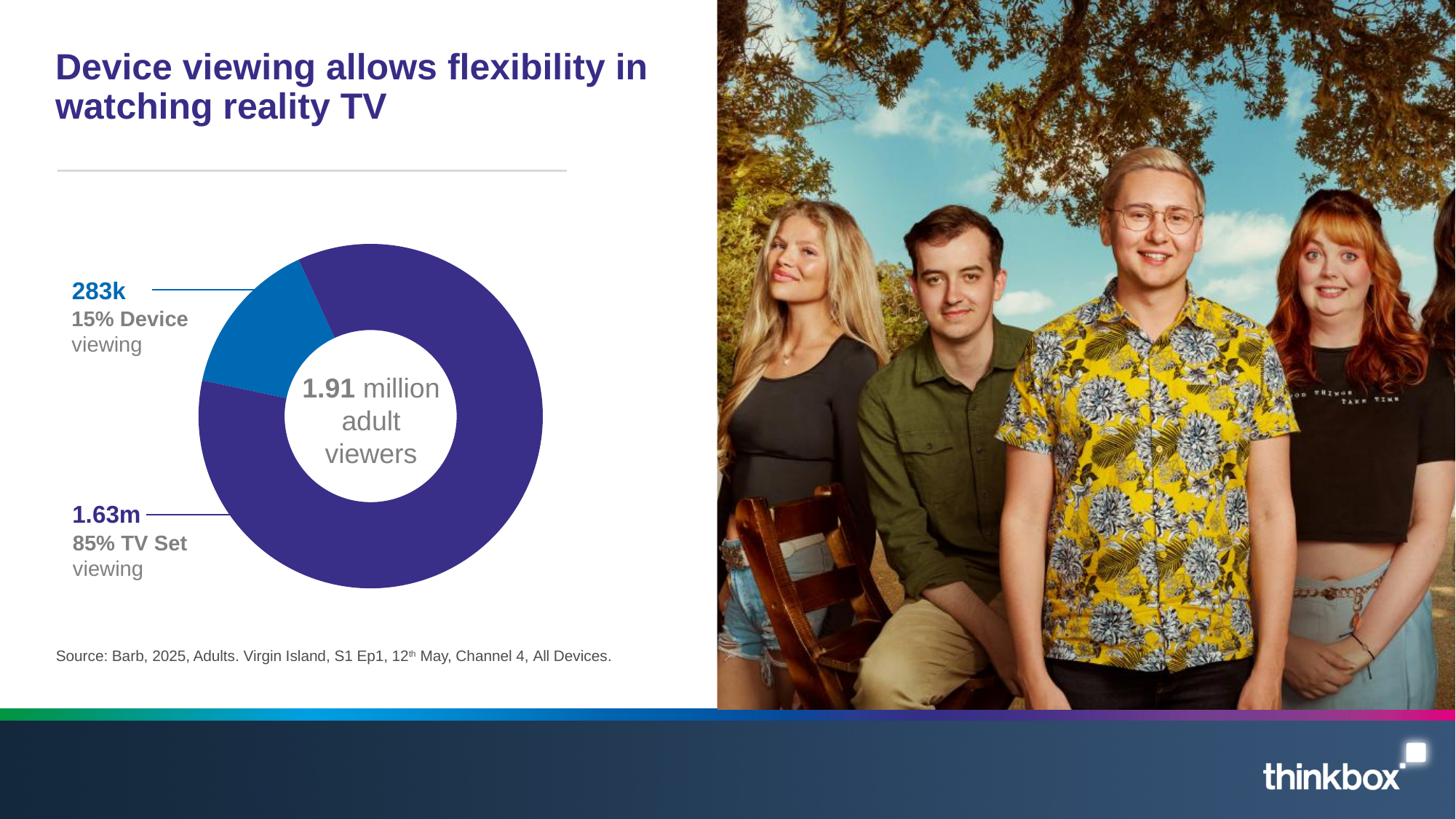
What share of viewing is TV Set viewing? 85% What total number of adult viewers is shown in the centre of the chart? 1.91 million What share of viewing is Device viewing? 15% What kind of chart is shown on the slide? Doughnut (pie) chart What is the difference in percentage points between TV Set viewing and Device viewing? 70 percentage points Which slice is the largest? TV Set viewing How many viewers does the Device viewing slice represent? 283k Which slice is the smallest? Device viewing How many slices does the chart have? 2 Which is larger, Device viewing or TV Set viewing? TV Set viewing How many viewers does the TV Set viewing slice represent? 1.63m What colour is the Device viewing slice? Blue